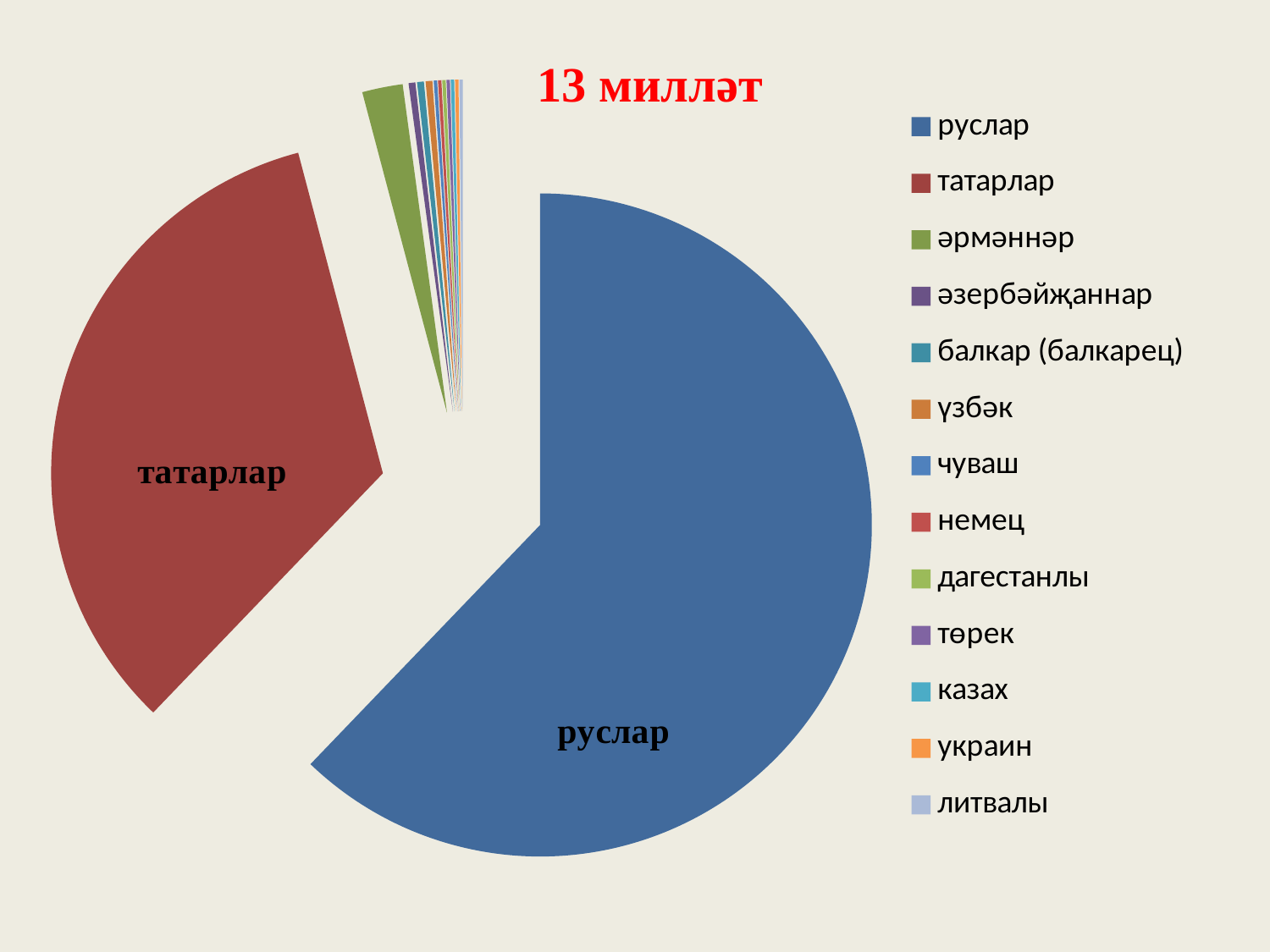
Which slice is larger, әрмәннәр or руслар? руслар Which category has the largest slice of the pie chart? руслар Which category is shown in blue in the pie chart? руслар Which two slices are labelled directly on the pie chart? татарлар and руслар Which category has the second-largest slice of the pie chart? татарлар Which slice is larger, руслар or татарлар? руслар How many categories does the legend of the pie chart list? 13 What is the title of the chart? 13 милләт Which slice is larger, татарлар or әрмәннәр? татарлар What kind of chart is shown on the slide? pie chart